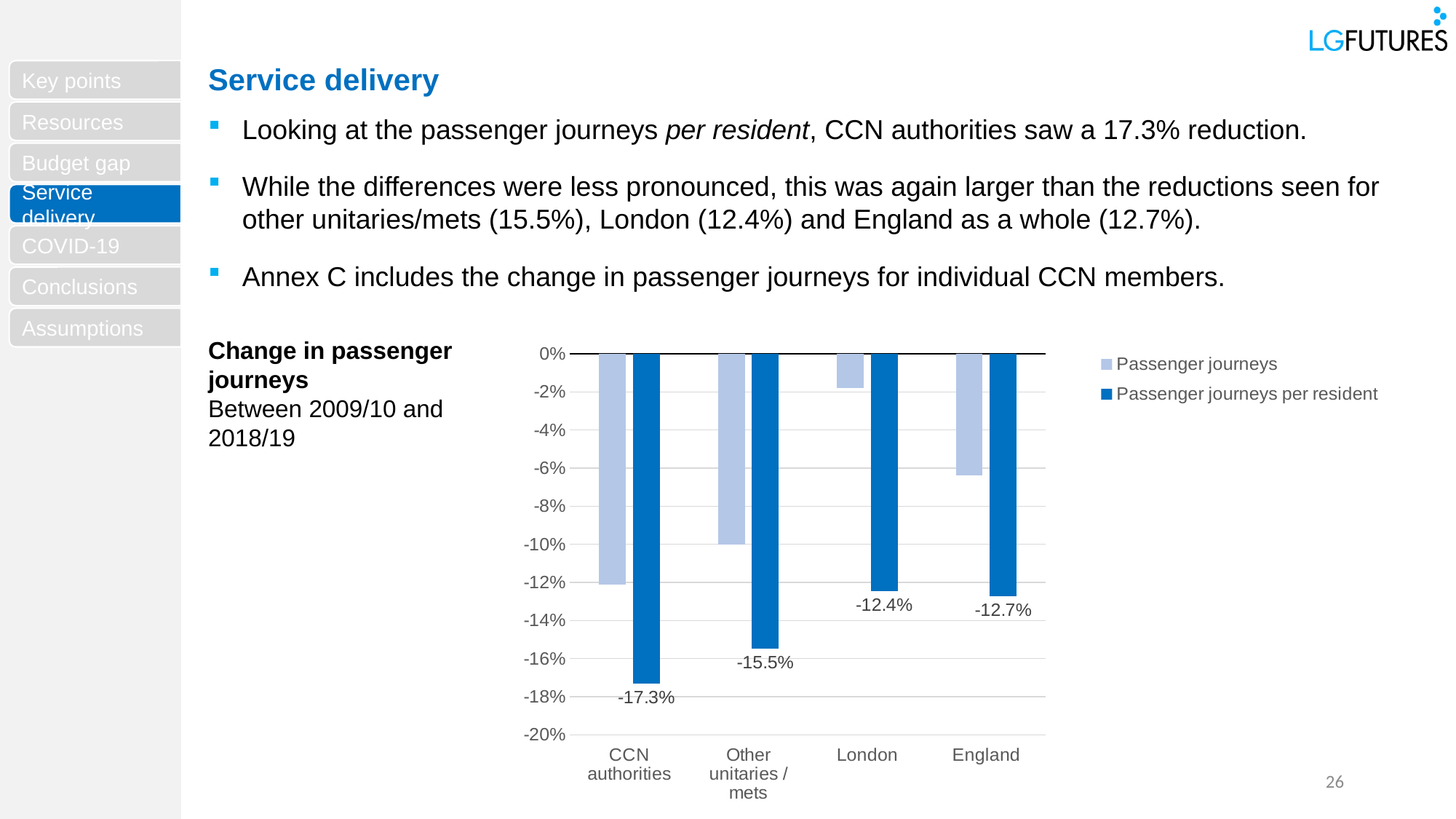
How many series does the chart legend list? 2 Which has the larger reduction in Passenger journeys per resident, London or England? England Which category shows the smallest reduction in Passenger journeys per resident? London What is the value for Passenger journeys per resident for London? -12.4% Which category shows the largest reduction in Passenger journeys per resident? CCN authorities What is the value for Passenger journeys per resident for England? -12.7% What is the value for Passenger journeys per resident for CCN authorities? -17.3% What is the value for Passenger journeys per resident for Other unitaries / mets? -15.5% What is the difference in percentage points between the Passenger journeys per resident values for CCN authorities and Other unitaries / mets? 1.8 percentage points Is the Passenger journeys value for London greater or less than -4%? greater What kind of chart is shown on the slide? Bar chart How many categories are shown on the x axis of the chart? 4